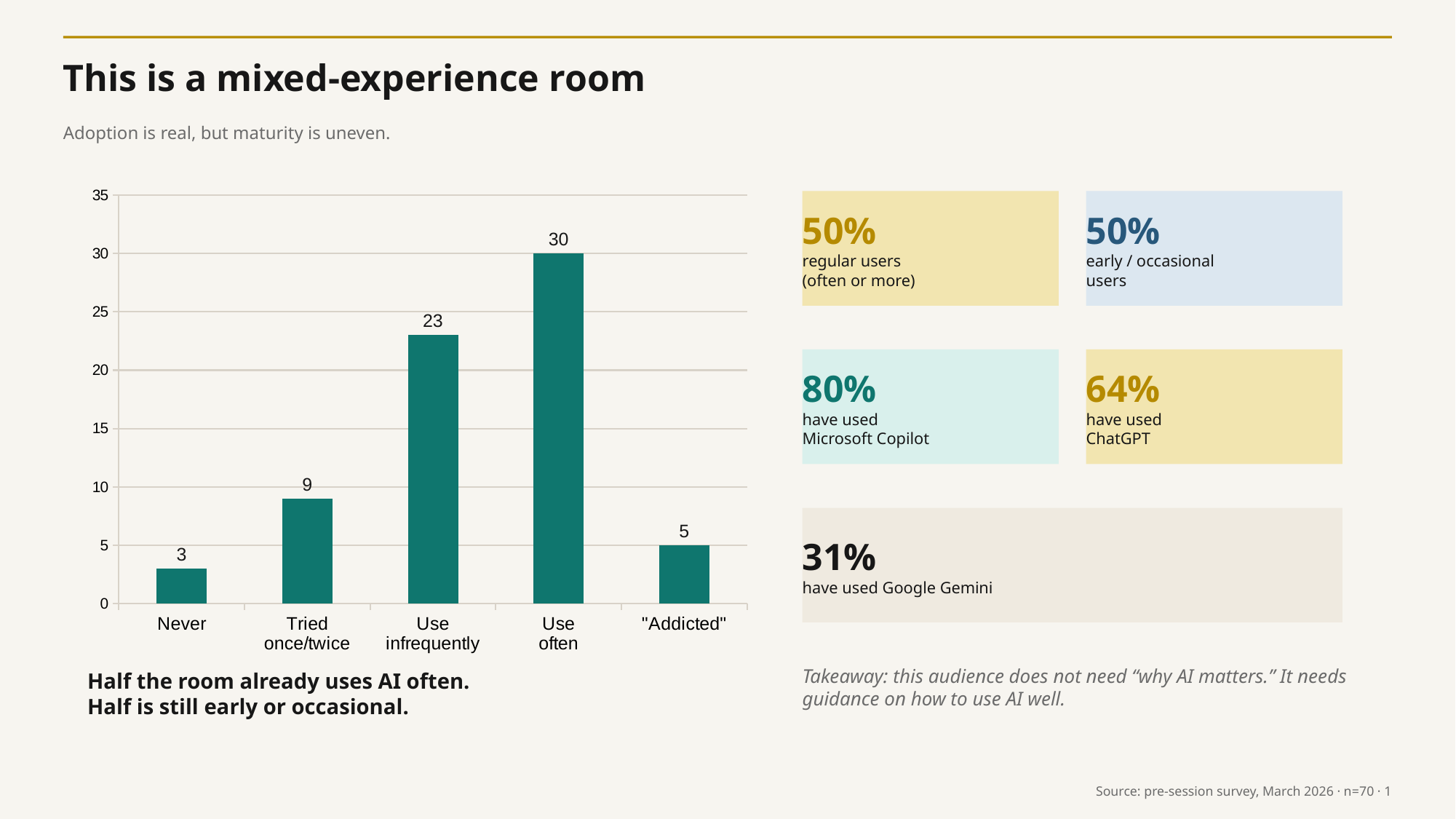
What is the value for "Tried once/twice"? 9 What is the value for "Use often"? 30 What is the highest value shown on the y axis? 35 Which is larger, the value for "Addicted" or the value for "Tried once/twice"? Tried once/twice What is the difference between the values for "Use often" and "Use infrequently"? 7 Which category has the lowest value? Never What is the value for "Never"? 3 What is the total of all five bar values? 70 Is the value for "Use infrequently" greater or less than 20? greater Which category has the highest value? Use often How many categories are shown on the x axis? 5 What kind of chart is shown on the slide? bar chart